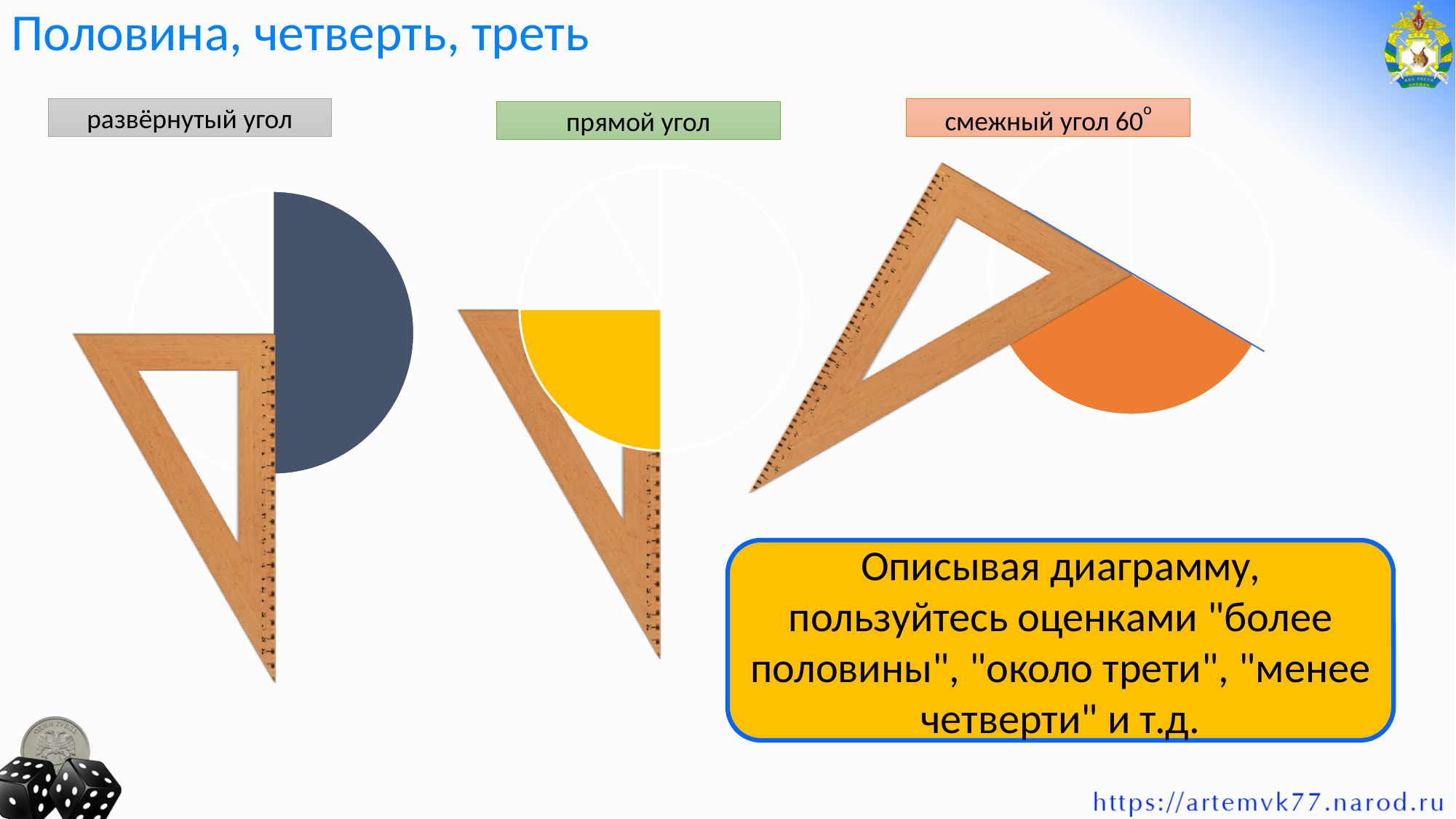
How many circle (pie) diagrams are shown on the slide? 3 What fraction of the circle does the orange sector in the "смежный угол 60°" chart cover? треть What fraction of the circle does the dark blue sector in the "развёрнутый угол" chart cover? половина Is the orange sector in the "смежный угол 60°" chart greater or less than a quarter of the circle? greater What is the label above the rightmost chart? смежный угол 60° Which chart has the smallest shaded sector? прямой угол Which chart has the largest shaded sector? развёрнутый угол Which sector is larger, the dark blue one in the "развёрнутый угол" chart or the yellow one in the "прямой угол" chart? dark blue Is the orange sector in the "смежный угол 60°" chart greater or less than half of the circle? less What colour is the shaded sector in the "прямой угол" chart? yellow What fraction of the circle does the yellow sector in the "прямой угол" chart cover? четверть What kind of chart is used under the label "развёрнутый угол"? pie chart